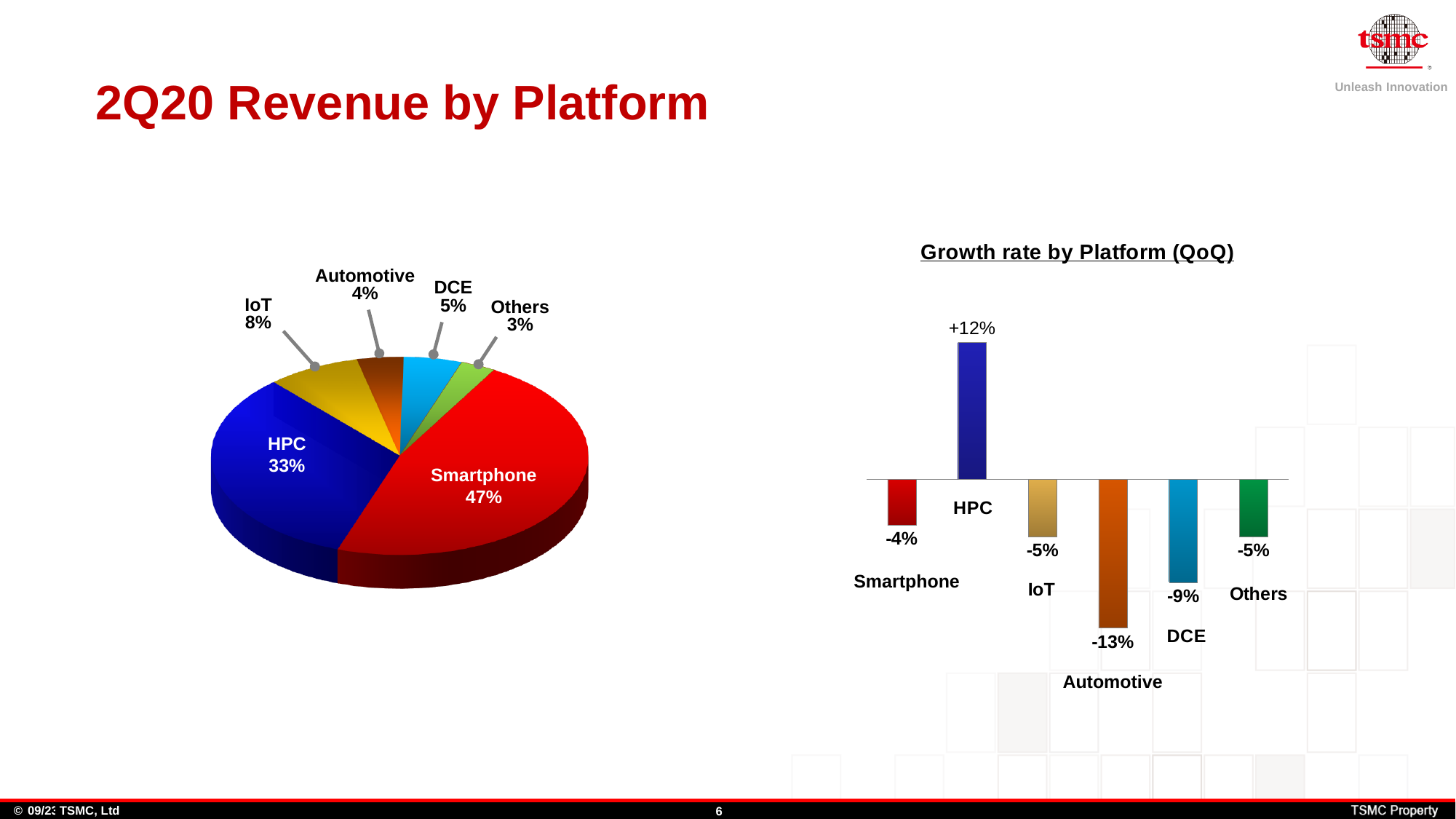
In the pie chart on the left, what is the difference in share between Smartphone and HPC? 14% In the pie chart on the left, which platform has the largest share of revenue? Smartphone In the 'Growth rate by Platform (QoQ)' chart, which platform has the lowest growth rate? Automotive What kind of chart is the 'Growth rate by Platform (QoQ)' chart? Bar chart In the pie chart on the left, which has a larger share, IoT or DCE? IoT In the 'Growth rate by Platform (QoQ)' chart, what is the growth rate for Automotive? -13% In the 'Growth rate by Platform (QoQ)' chart, which has a higher growth rate, Smartphone or DCE? Smartphone In the pie chart on the left, how many platform categories are shown? 6 In the pie chart on the left, what share of 2Q20 revenue does Smartphone account for? 47% In the pie chart on the left, which platform has the smallest share of revenue? Others In the pie chart on the left, what share of revenue does HPC account for? 33% In the 'Growth rate by Platform (QoQ)' chart, what is the growth rate for HPC? +12%